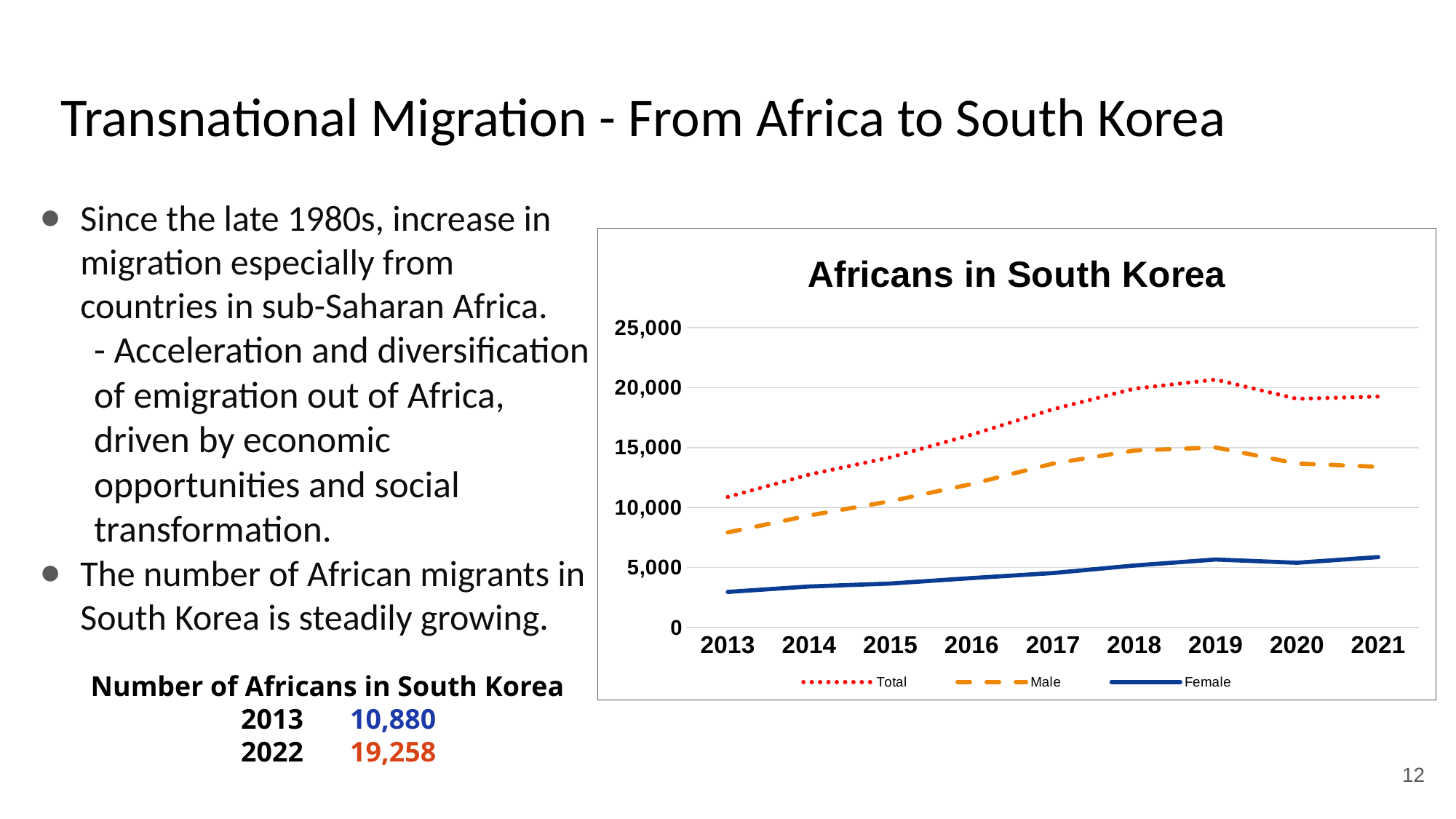
What is the title of the chart? Africans in South Korea In which year does the Total series reach its highest value? 2019 Is the Male value for 2013 greater or less than 10,000? less Does the Total series rise or fall from 2013 to 2019? rise In which year is the Female series at its lowest value? 2013 Is the Female value for 2013 greater or less than 5,000? less Is the Total value for 2021 greater or less than 20,000? less How many series does the chart's legend list? 3 Which series are listed in the chart's legend? Total, Male, Female How many years are shown on the x axis of the chart? 9 What kind of chart is shown on the slide? line chart